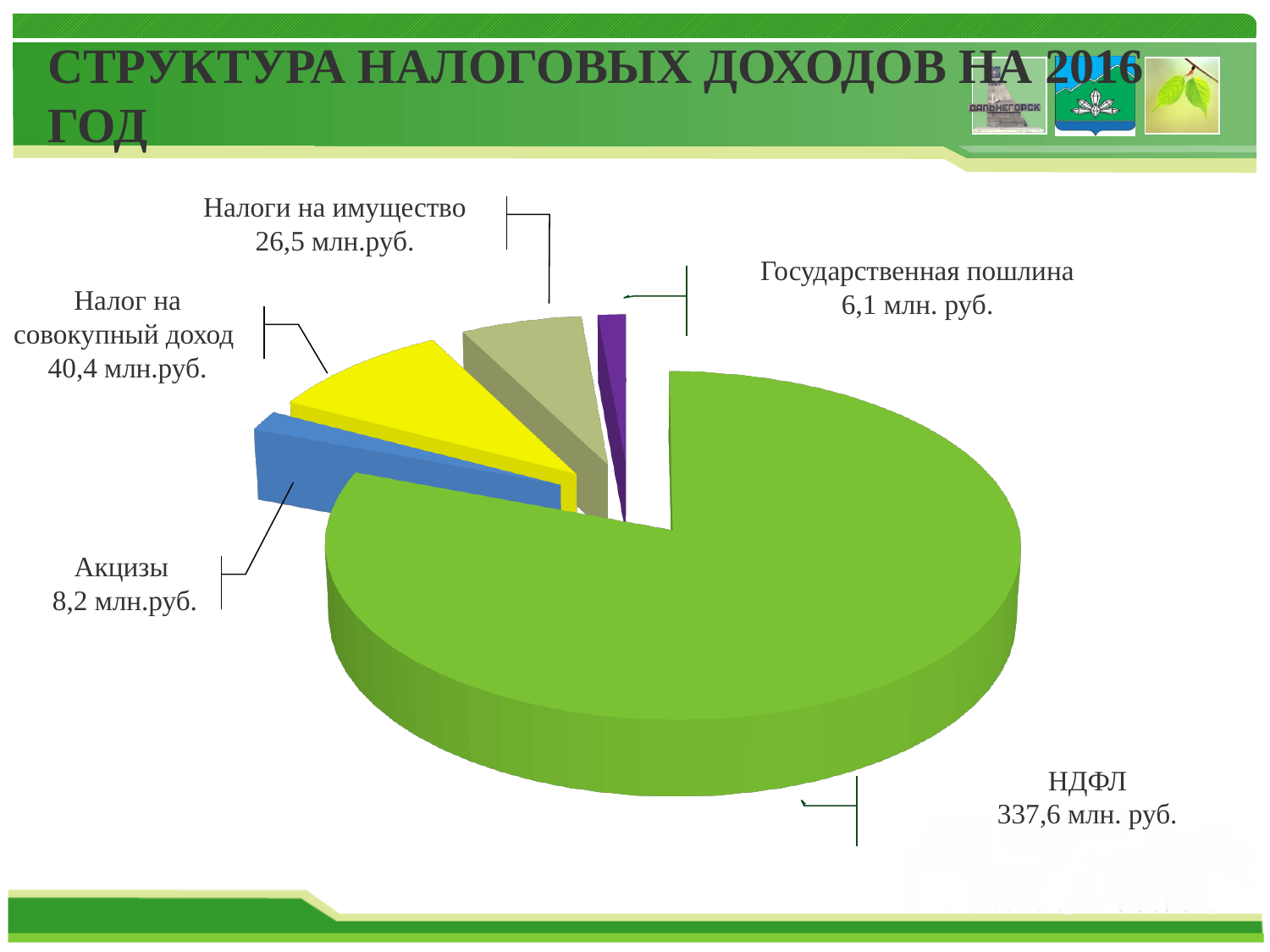
What is the difference between Налог на совокупный доход and Налоги на имущество? 13,9 млн.руб. Which is larger, Акцизы or Государственная пошлина? Акцизы Which category has the largest value? НДФЛ What is the title of the slide containing the chart? СТРУКТУРА НАЛОГОВЫХ ДОХОДОВ НА 2016 ГОД What kind of chart is shown on the slide? pie chart What is the value for Налоги на имущество? 26,5 млн.руб. What is the value for Налог на совокупный доход? 40,4 млн.руб. Which category has the smallest value? Государственная пошлина How many slices does the pie chart have? 5 What is the value for Акцизы? 8,2 млн.руб. What is the value for Государственная пошлина? 6,1 млн. руб. What is the value for НДФЛ? 337,6 млн. руб.